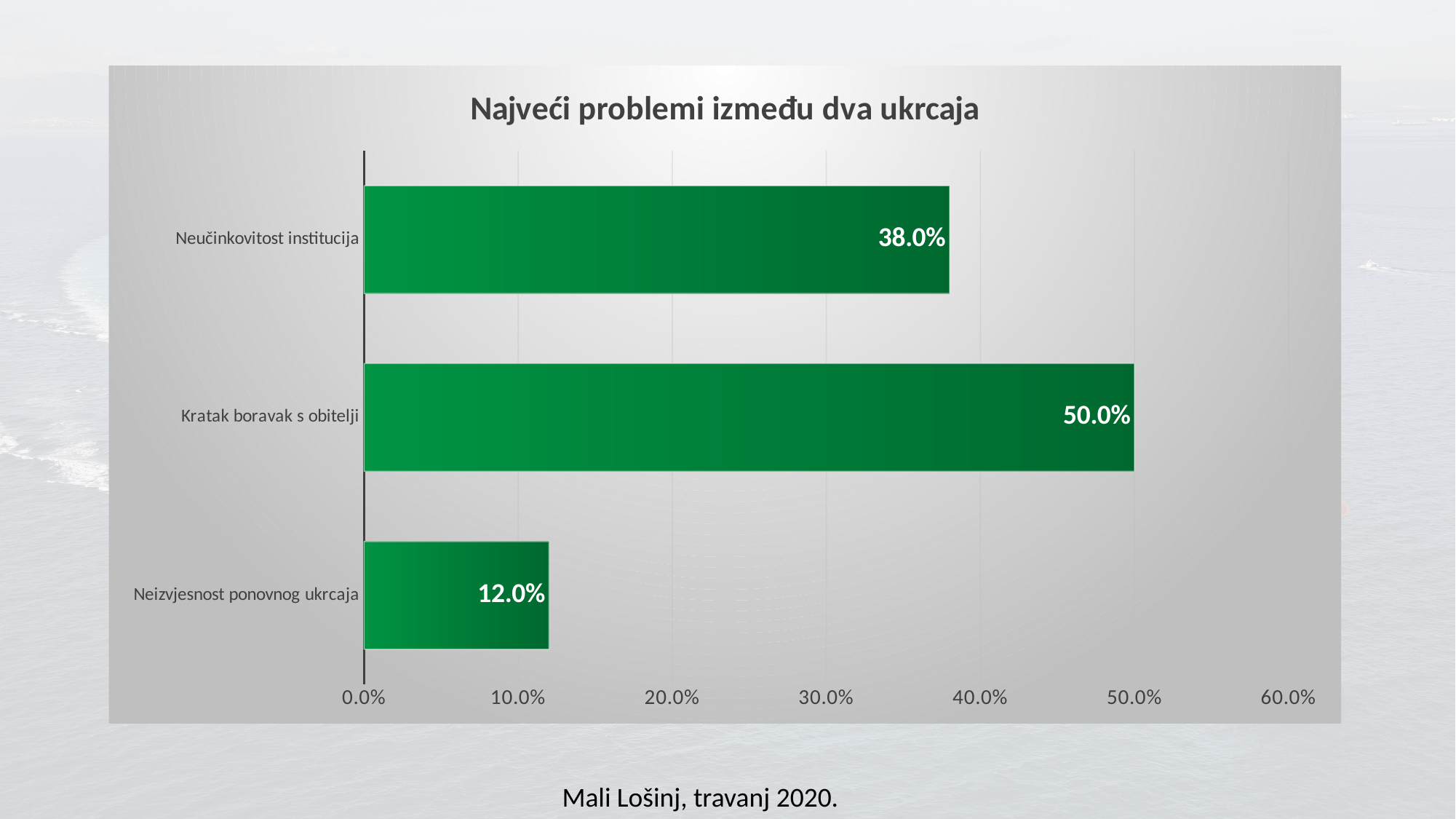
Which category has the highest value? Kratak boravak s obitelji What is the value for Neučinkovitost institucija? 38.0% What is the value for Neizvjesnost ponovnog ukrcaja? 12.0% What is the difference between the values for Neučinkovitost institucija and Neizvjesnost ponovnog ukrcaja? 26.0% What is the title of the chart? Najveći problemi između dva ukrcaja What is the difference between the values for Kratak boravak s obitelji and Neučinkovitost institucija? 12.0% Which category has the lowest value? Neizvjesnost ponovnog ukrcaja How many categories are shown in the chart? 3 What is the value for Kratak boravak s obitelji? 50.0% What kind of chart is shown on the slide? bar chart Which is larger, the value for Neučinkovitost institucija or the value for Neizvjesnost ponovnog ukrcaja? Neučinkovitost institucija Is the value for Neučinkovitost institucija greater or less than 40.0%? less